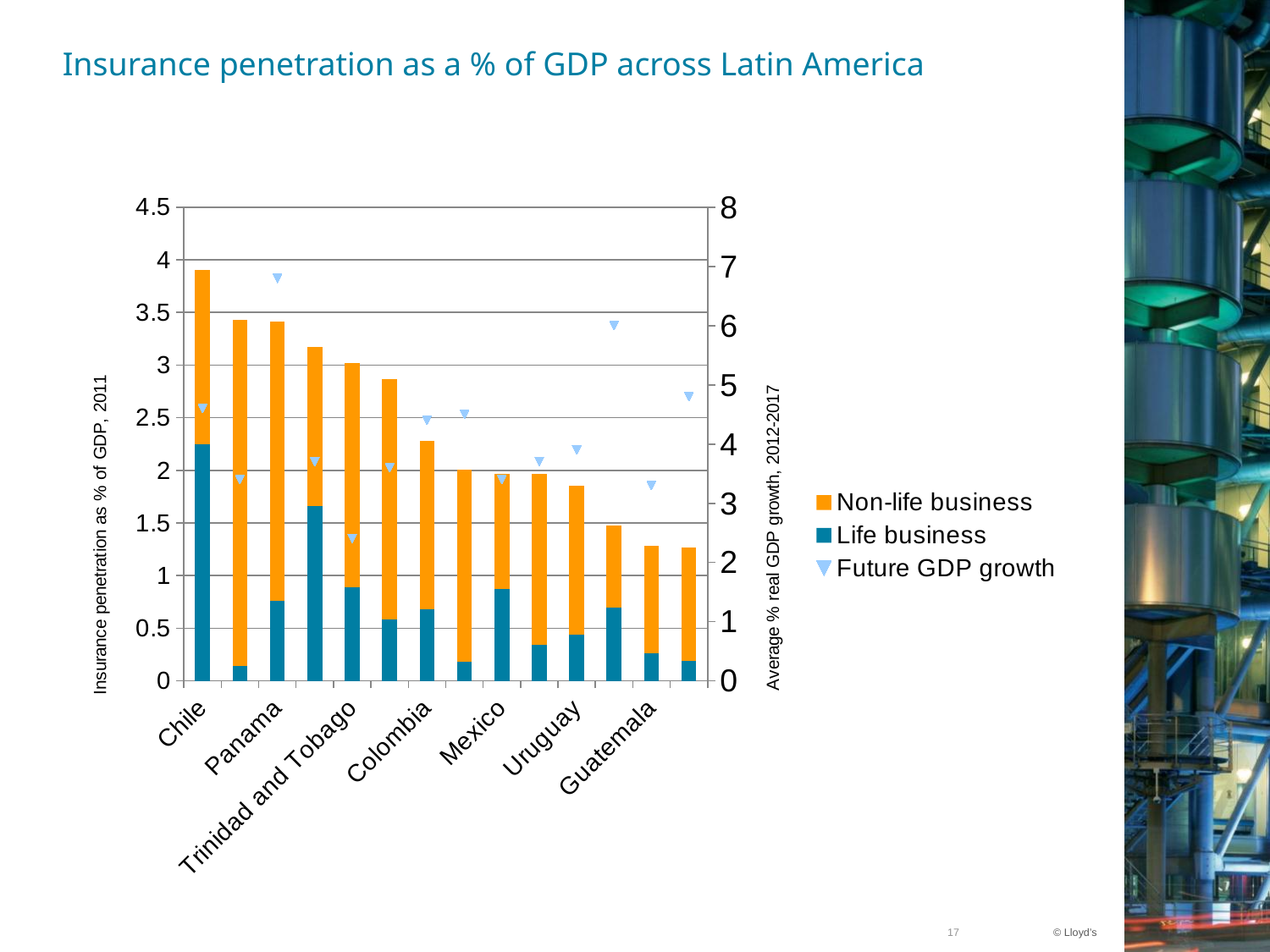
What are the three entries in the chart legend? Non-life business, Life business, Future GDP growth Is the total insurance penetration bar for Chile greater or less than 3.5? greater What kind of chart is shown on the slide? combination chart: stacked bars with markers (Future GDP growth points) What is the title of the chart? Insurance penetration as a % of GDP across Latin America Is the total insurance penetration bar for Guatemala greater or less than 1.5? less Is the Life business value for Panama greater or less than 1? less Which country has the highest total insurance penetration bar? Chile Do the total insurance penetration bars rise or fall from left to right across the x axis? fall Which has the larger total insurance penetration bar, Chile or Guatemala? Chile How many series does the legend list? 3